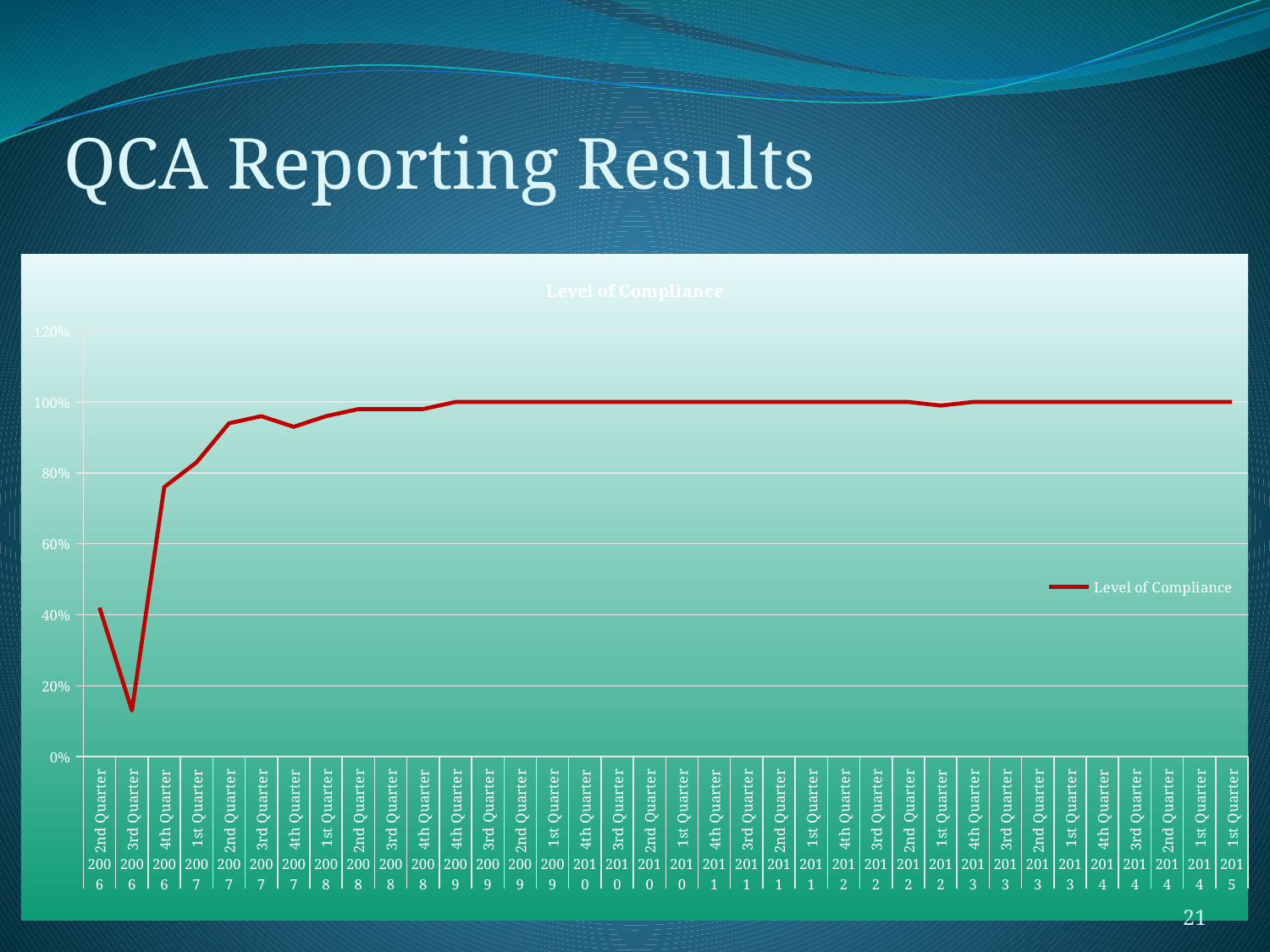
Which is larger, the value for 2nd Quarter 2006 or the value for 3rd Quarter 2006? 2nd Quarter 2006 Is the value for 2nd Quarter 2006 greater or less than 60%? less Which quarter has the lowest level of compliance? 3rd Quarter 2006 Is the value for 4th Quarter 2006 greater or less than 60%? greater How many series does the legend list? 1 Does the level of compliance generally rise or fall from 3rd Quarter 2006 to 1st Quarter 2015? rise What is the title of the chart? Level of Compliance What kind of chart is shown on the slide? line chart What is the name of the series shown in the legend? Level of Compliance Is the value for 1st Quarter 2015 greater or less than 80%? greater